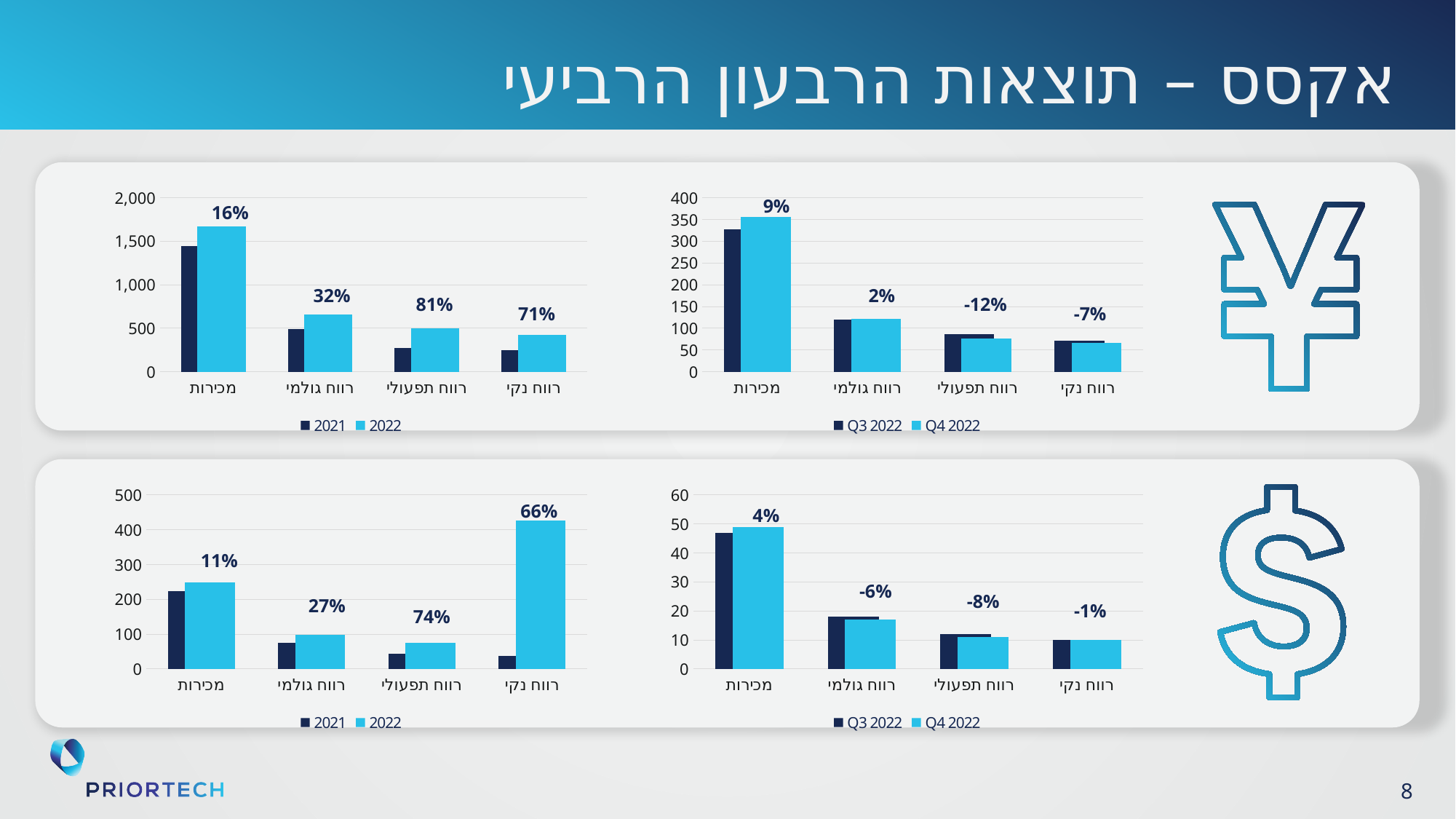
How many categories are shown on the x axis of the bottom-left chart? 4 In the bottom-left chart, is the 2022 value for רווח נקי greater or less than 400? greater How many series does the legend of the top-right chart list? 2 What kind of chart is the top-left chart? bar chart In the bottom-right chart, what percentage change is labelled above the רווח גולמי bars? -6% In the top-right chart, is the Q3 2022 value for מכירות greater or less than 300? greater In the top-right chart, what percentage change is labelled above the רווח תפעולי bars? -12% In the top-left chart, what percentage change is labelled above the מכירות bars? 16% In the bottom-left chart, what percentage change is labelled above the רווח נקי bars? 66% In the top-left chart, which category has the highest percentage change label? רווח תפעולי In the top-left chart, what percentage change is labelled above the רווח תפעולי bars? 81% In the top-left chart, is the 2022 value for מכירות greater or less than 1,500? greater